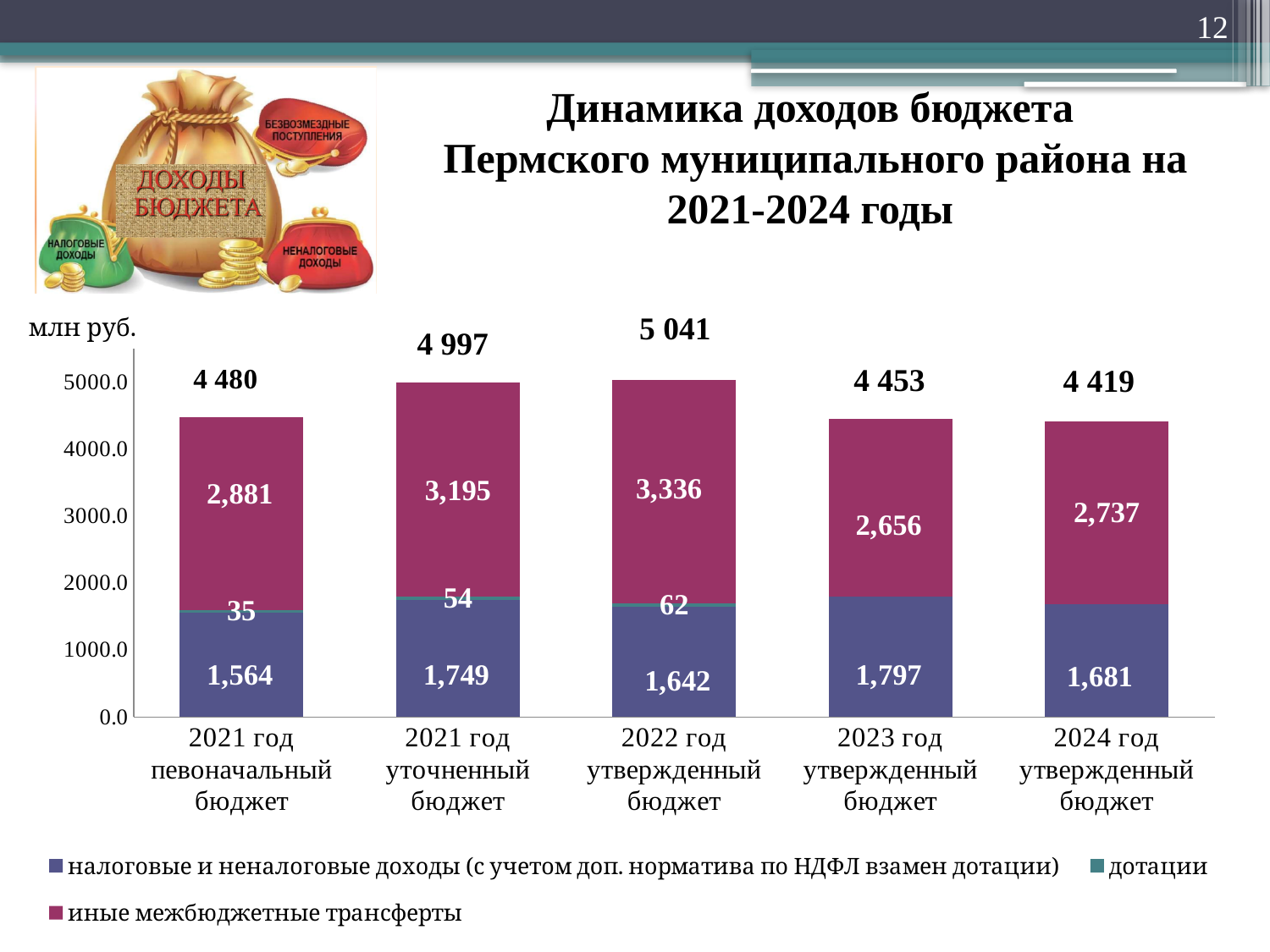
Which is larger: иные межбюджетные трансферты for 2023 год or for 2024 год? 2024 год (2,737) What is the value of налоговые и неналоговые доходы for 2023 год утвержденный бюджет? 1,797 What is the value of дотации for 2022 год утвержденный бюджет? 62 What type of chart is shown on the slide? stacked bar chart What unit is indicated for the values on the chart? млн руб. How many categories (budget years) are shown on the x axis? 5 Which budget year has the lowest total? 2024 год утвержденный бюджет How many series does the legend list? 3 What is the difference between the totals for 2021 год уточненный бюджет and 2021 год певоначальный бюджет? 517 What is the total printed above the bar for 2022 год утвержденный бюджет? 5 041 What is the value of иные межбюджетные трансферты for 2021 год уточненный бюджет? 3,195 Which budget year has the highest total? 2022 год утвержденный бюджет